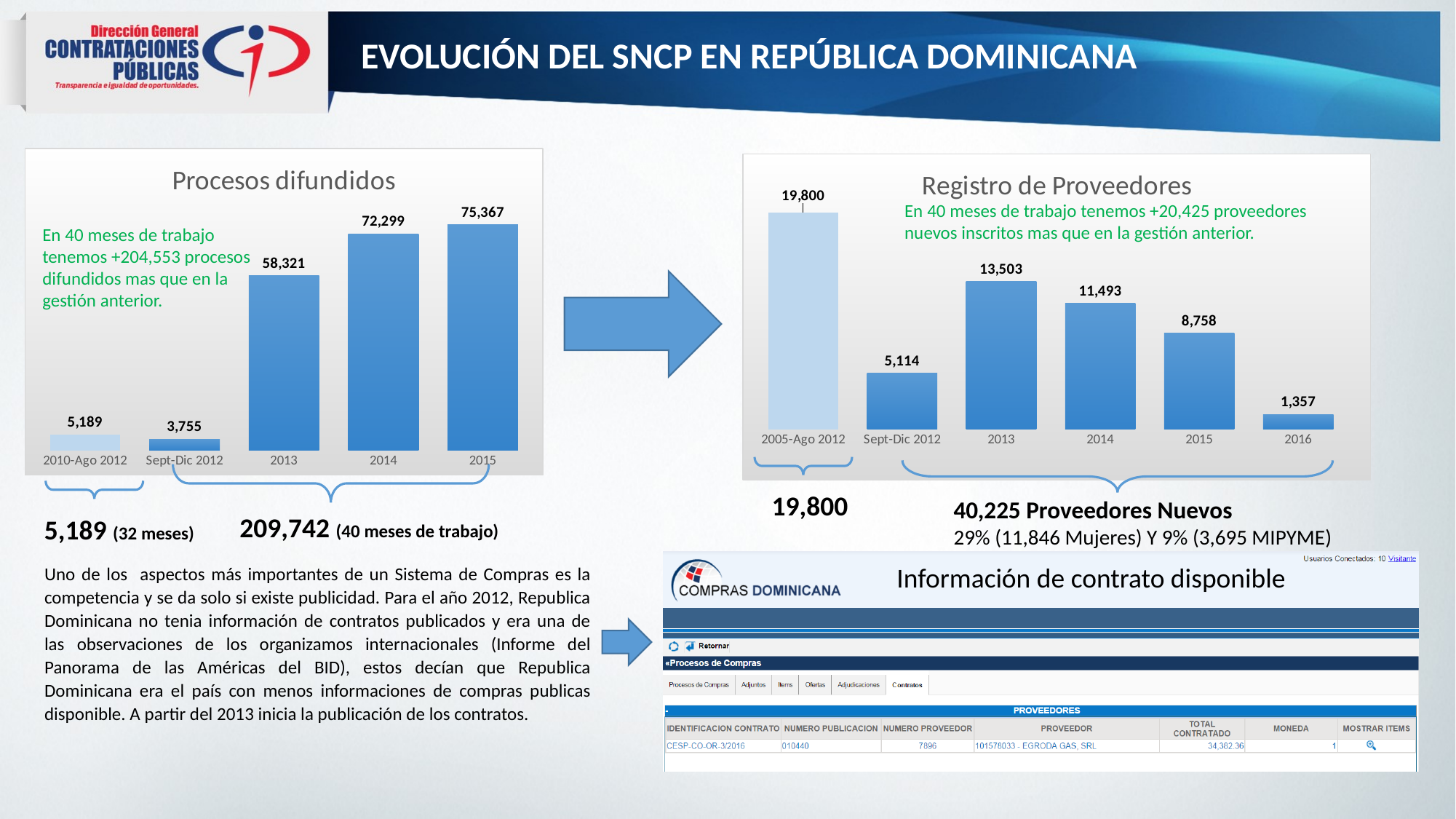
In the 'Procesos difundidos' chart, do the values rise or fall from 2013 to 2015? rise In the 'Procesos difundidos' chart, what is the difference between the values for 2015 and 2014? 3,068 In the 'Registro de Proveedores' chart, what is the difference between the values for 2013 and 2014? 2,010 In the 'Procesos difundidos' chart, what is the value for 2014? 72,299 In the 'Procesos difundidos' chart, which category has the lowest value? Sept-Dic 2012 In the 'Registro de Proveedores' chart, what is the value for 2015? 8,758 What kind of chart is the 'Registro de Proveedores' chart? bar chart In the 'Registro de Proveedores' chart, which category has the highest value? 2005-Ago 2012 In the 'Procesos difundidos' chart, how many categories are shown on the x axis? 5 In the 'Registro de Proveedores' chart, is the value for 2013 larger or the value for 2014? 2013 In the 'Registro de Proveedores' chart, which category has the lowest value? 2016 In the 'Procesos difundidos' chart, which category has the highest value? 2015